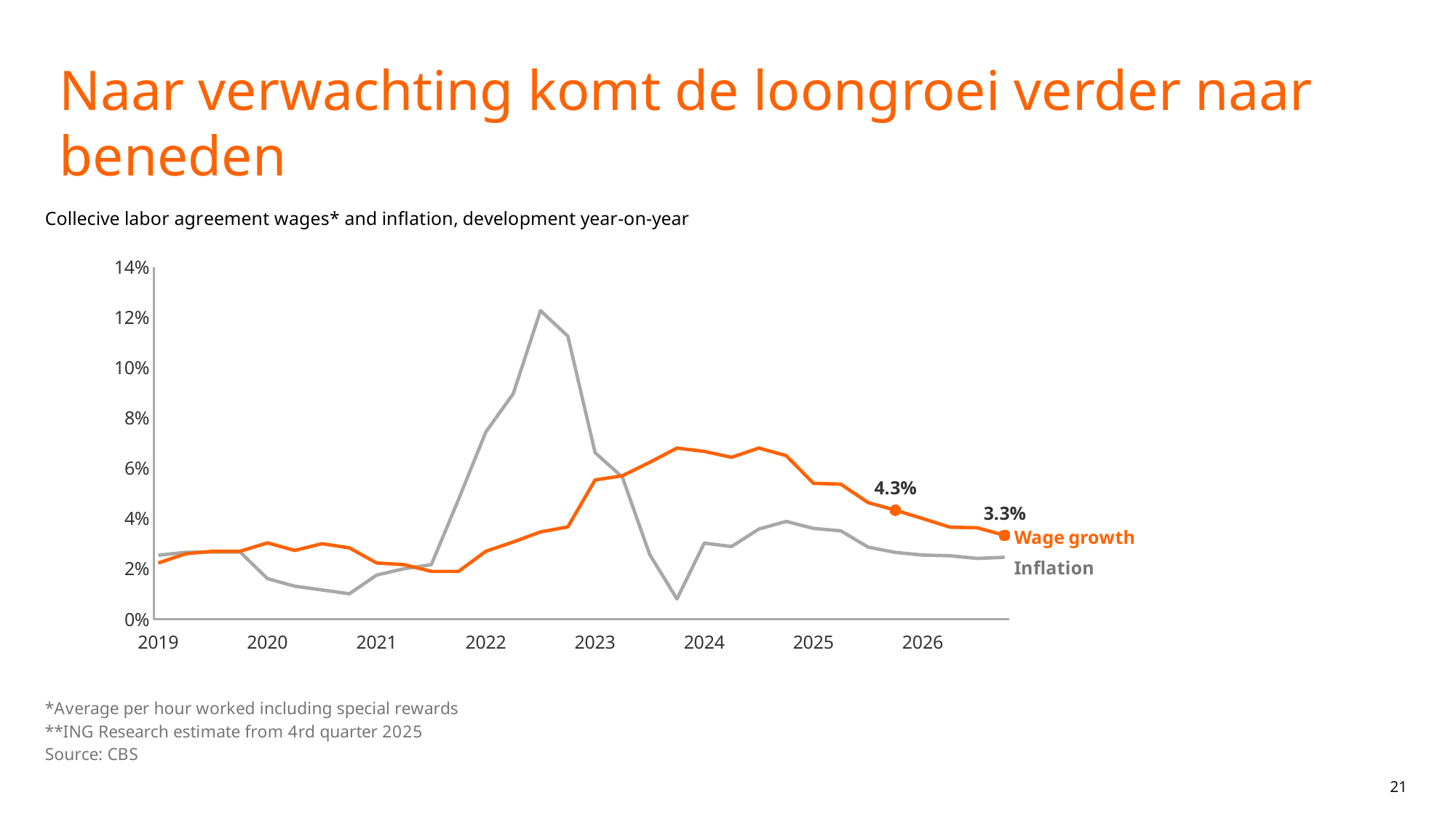
What kind of chart is shown on the slide? line chart Is the peak value of the Inflation line in 2022 greater or less than 10%? greater What colour is the Wage growth line? orange Is the lowest value of the Inflation line in 2023 greater or less than 2%? less Does the Wage growth line rise or fall from 2025 to the end of the chart? fall What is the difference between the two labelled Wage growth values, 4.3% and 3.3%? 1.0 percentage points Is the highest value of the Wage growth line greater or less than 6%? greater How many series are plotted on the chart? 2 At the right end of the chart, which series is higher: Wage growth or Inflation? Wage growth What is the last labelled value of the Wage growth line at the right end of the chart? 3.3% Which series reaches the highest value anywhere on the chart? Inflation What is the labelled value of the Wage growth line at the point between 2025 and 2026? 4.3%